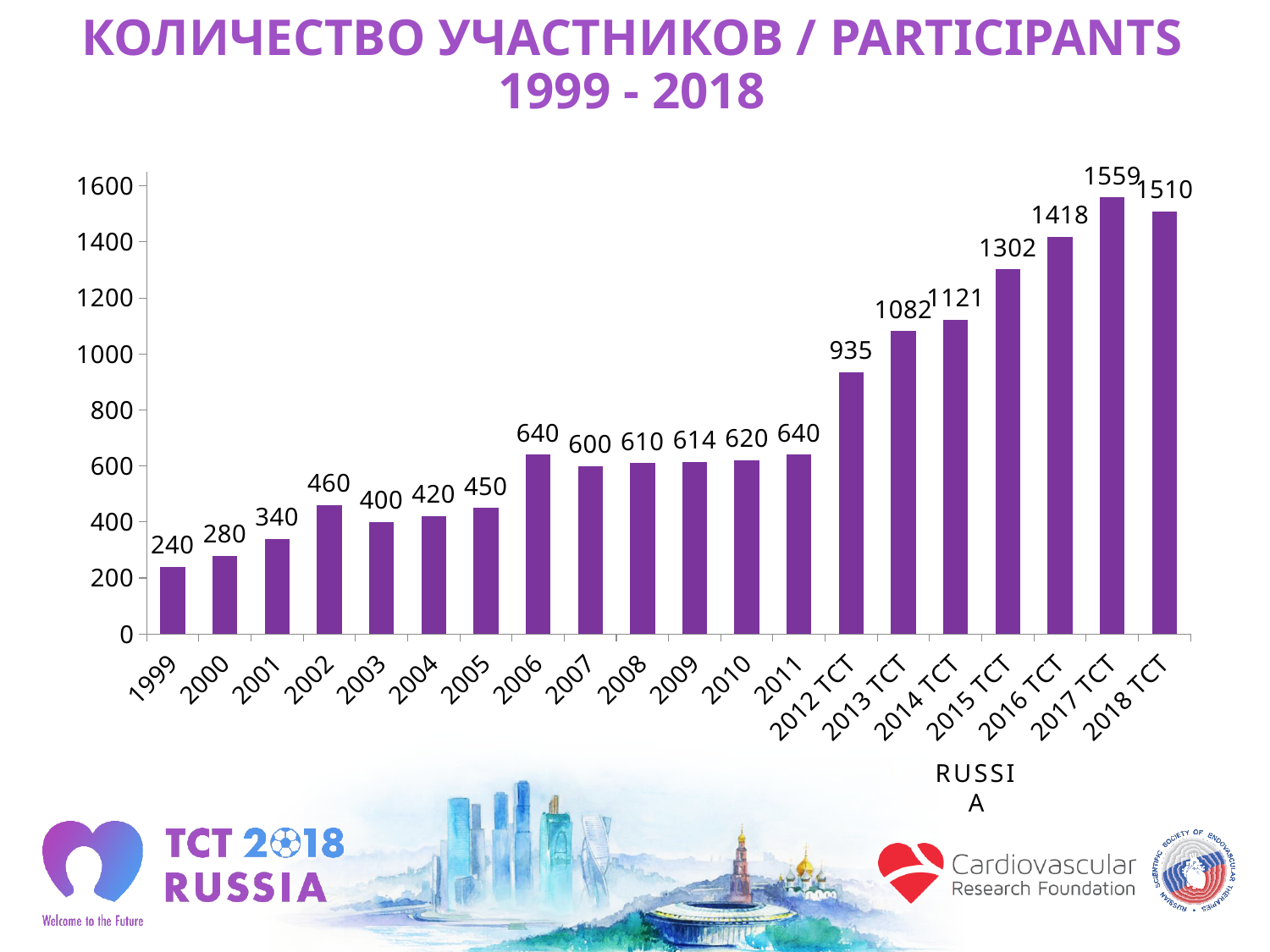
Do the values generally rise or fall from 2011 to 2017 TCT? rise What is the number of participants for 1999? 240 Which category has the highest number of participants? 2017 TCT Which has more participants, 2002 or 2005? 2002 What is the number of participants for 2003? 400 Which category has the lowest number of participants? 1999 What is the difference in participants between 2017 TCT and 2018 TCT? 49 How many categories are shown on the x axis? 20 What is the number of participants for 2015 TCT? 1302 What is the difference in participants between 2012 TCT and 2011? 295 What kind of chart is shown on the slide? bar chart Is the value for 2013 TCT greater or less than 1000? greater